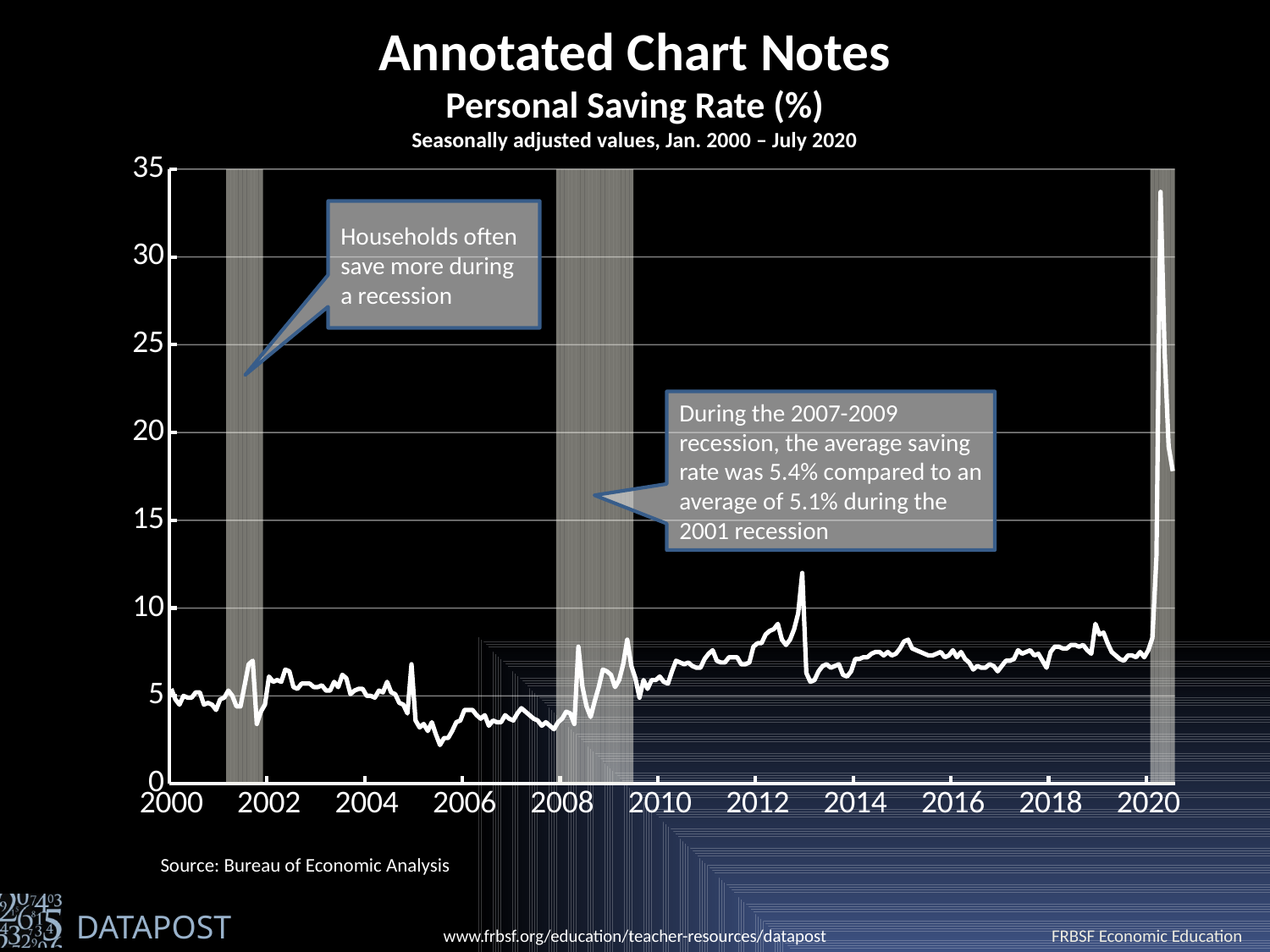
According to the annotation, what was the average saving rate during the 2007-2009 recession? 5.4% What is the title of the chart? Personal Saving Rate (%) Is the personal saving rate in 2005 greater or less than 5? less According to the annotation, what was the average saving rate during the 2001 recession? 5.1% What source is cited for the chart data? Bureau of Economic Analysis How many shaded recession bands are shown on the chart? 3 Which recession had the higher average saving rate according to the annotations, 2001 or 2007-2009? 2007-2009 What is the difference between the average saving rate in the 2007-2009 recession and the 2001 recession, as stated in the annotation? 0.3 percentage points Is the personal saving rate in 2016 greater or less than 10? less What kind of chart is shown on the slide? line chart In which year does the personal saving rate reach its highest value on the chart? 2020 Is the peak value of the personal saving rate in 2020 greater or less than 30? greater